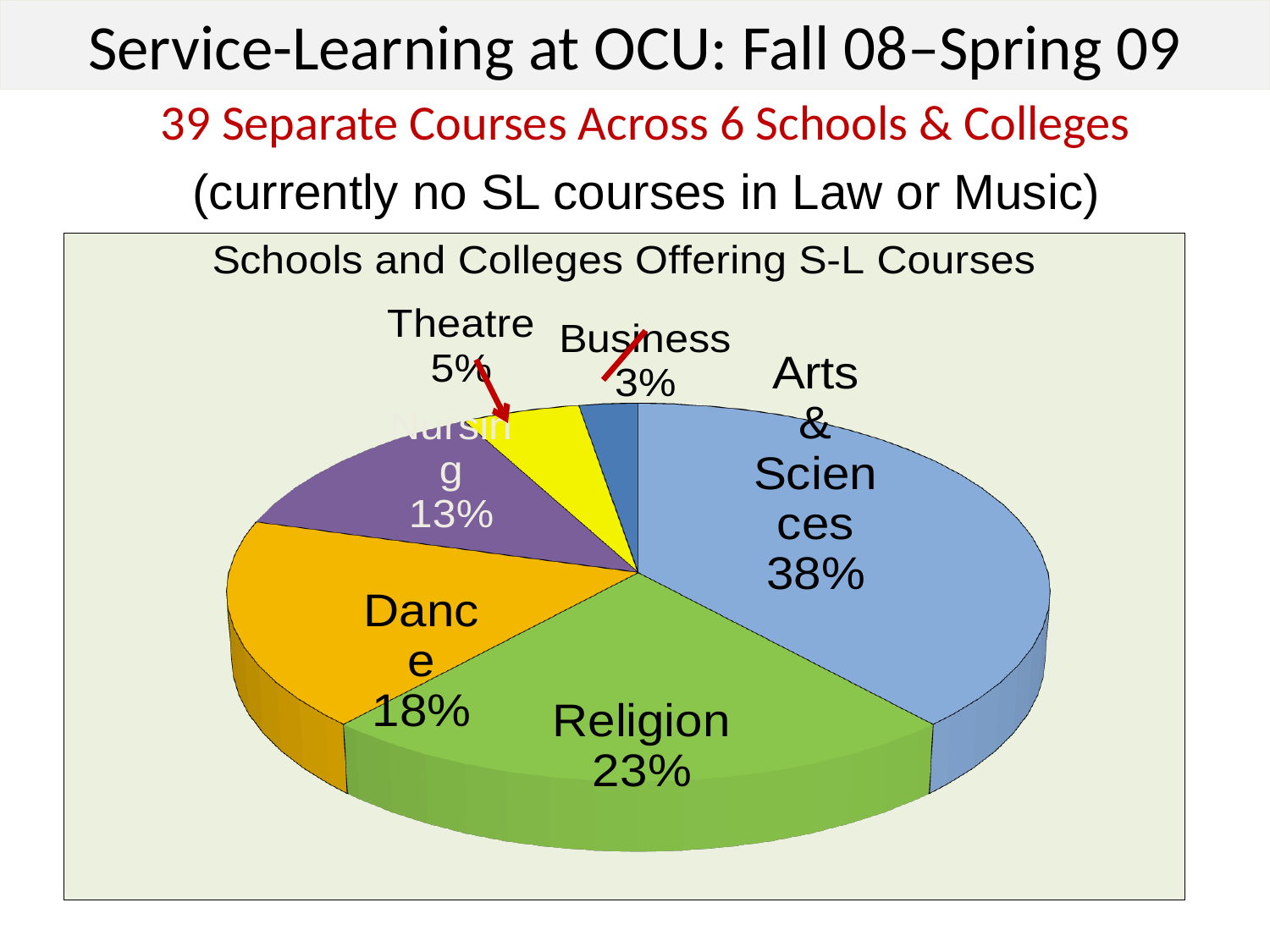
What is the title of the chart? Schools and Colleges Offering S-L Courses Which is larger, the share for Nursing or the share for Theatre? Nursing Which school or college has the smallest slice of the pie? Business How many slices does the pie chart have? 6 What percentage is shown for Business? 3% What percentage is shown for Dance? 18% Which school or college has the largest slice of the pie? Arts & Sciences What share of the pie does Religion have? 23% What share of the pie does Arts & Sciences have? 38% What percentage is shown for Nursing? 13% What is the difference in percentage points between Religion and Dance? 5 What kind of chart is shown on the slide? pie chart